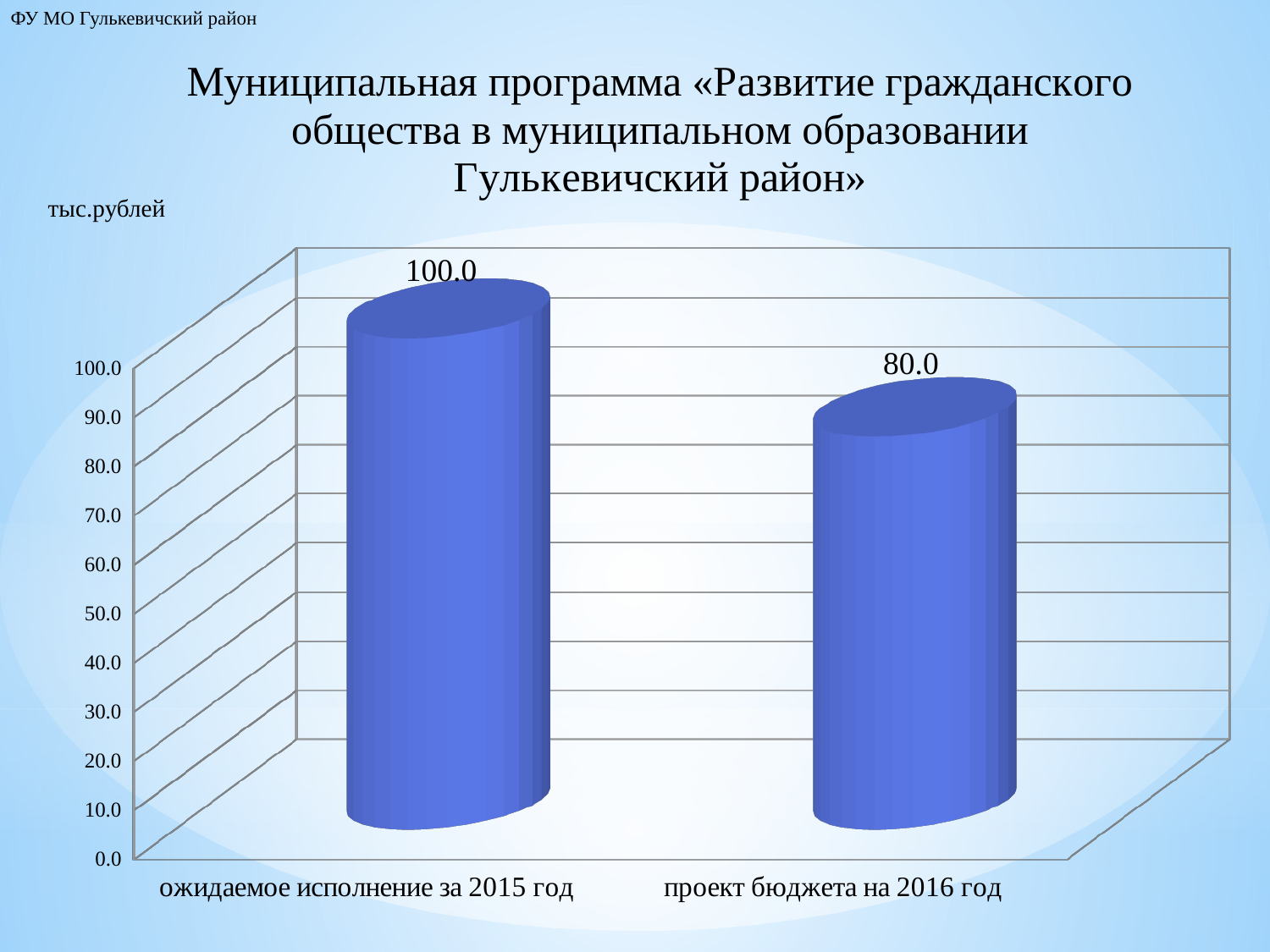
What is the maximum value shown on the vertical axis? 100.0 Do the values rise or fall from 2015 to 2016? fall What is the value for «ожидаемое исполнение за 2015 год»? 100.0 What kind of chart is shown on the slide? bar chart What is the value for «проект бюджета на 2016 год»? 80.0 Which category has the lowest value? проект бюджета на 2016 год Which is larger: the value for «ожидаемое исполнение за 2015 год» or for «проект бюджета на 2016 год»? ожидаемое исполнение за 2015 год How many categories are shown on the chart? 2 What is the difference between the value for 2015 and the value for 2016? 20.0 Is the value for «проект бюджета на 2016 год» greater or less than 90.0? less What unit is indicated above the chart? тыс.рублей Which category has the highest value? ожидаемое исполнение за 2015 год